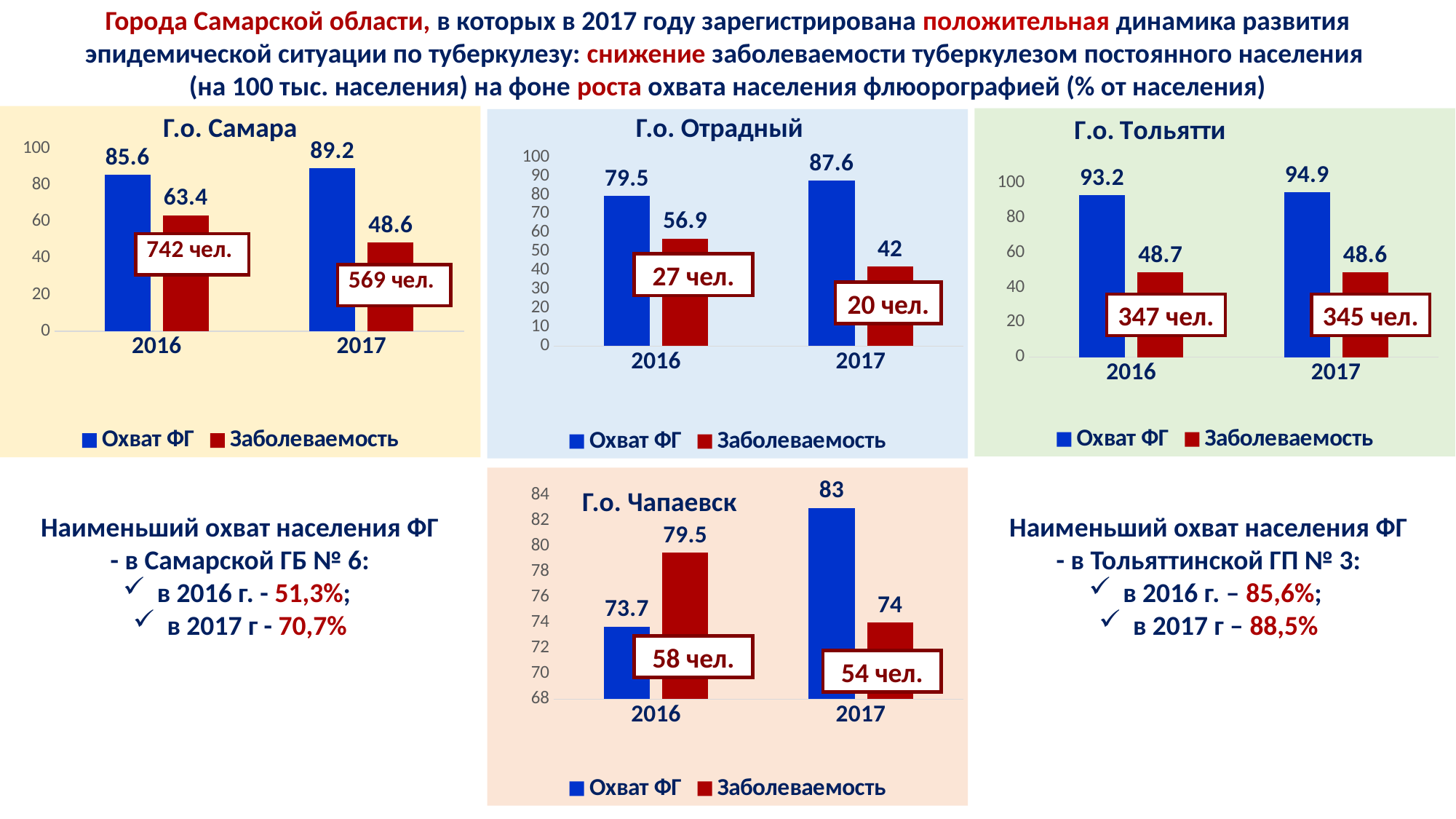
In the Г.о. Отрадный chart, by how much did Охват ФГ increase from 2016 to 2017? 8.1 How many series does the legend of the Г.о. Отрадный chart list? 2 In the Г.о. Самара chart, does Заболеваемость rise or fall from 2016 to 2017? fall In the Г.о. Чапаевск chart, what is the value of Заболеваемость for 2016? 79.5 In the Г.о. Чапаевск chart, what is the difference between Заболеваемость in 2016 and 2017? 5.5 In the Г.о. Тольятти chart, which series is shown in blue? Охват ФГ In the Г.о. Самара chart, what is the value of Охват ФГ for 2017? 89.2 In the Г.о. Отрадный chart, what is the value of Заболеваемость for 2017? 42 What type of chart is the Г.о. Чапаевск chart? bar chart In the Г.о. Тольятти chart, what is the value of Охват ФГ for 2016? 93.2 In the Г.о. Тольятти chart, which year has the higher Охват ФГ value, 2016 or 2017? 2017 In the Г.о. Самара chart, what is the value of Заболеваемость for 2016? 63.4